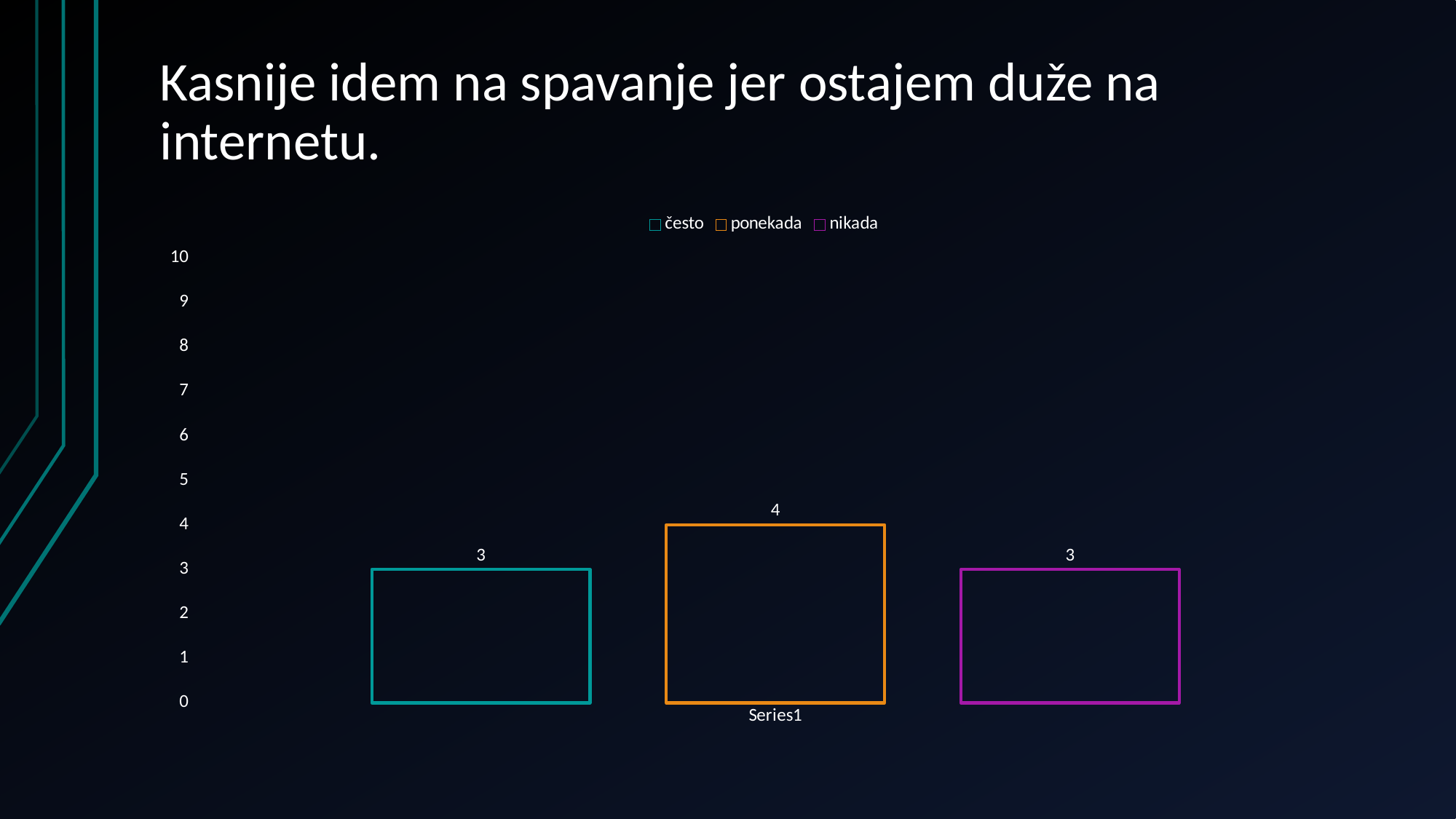
Which series has the highest value? ponekada What is the value for "ponekada"? 4 What kind of chart is shown on the slide? bar chart Which is larger, the value for "ponekada" or the value for "nikada"? ponekada What is the value for "nikada"? 3 Is the value for "ponekada" greater or less than 5? less What is the total of the three bars shown? 10 What is the difference between the values for "ponekada" and "često"? 1 What is the maximum value shown on the vertical axis? 10 What is the value for "često"? 3 How many series does the legend list? 3 What is the category label shown on the horizontal axis? Series1